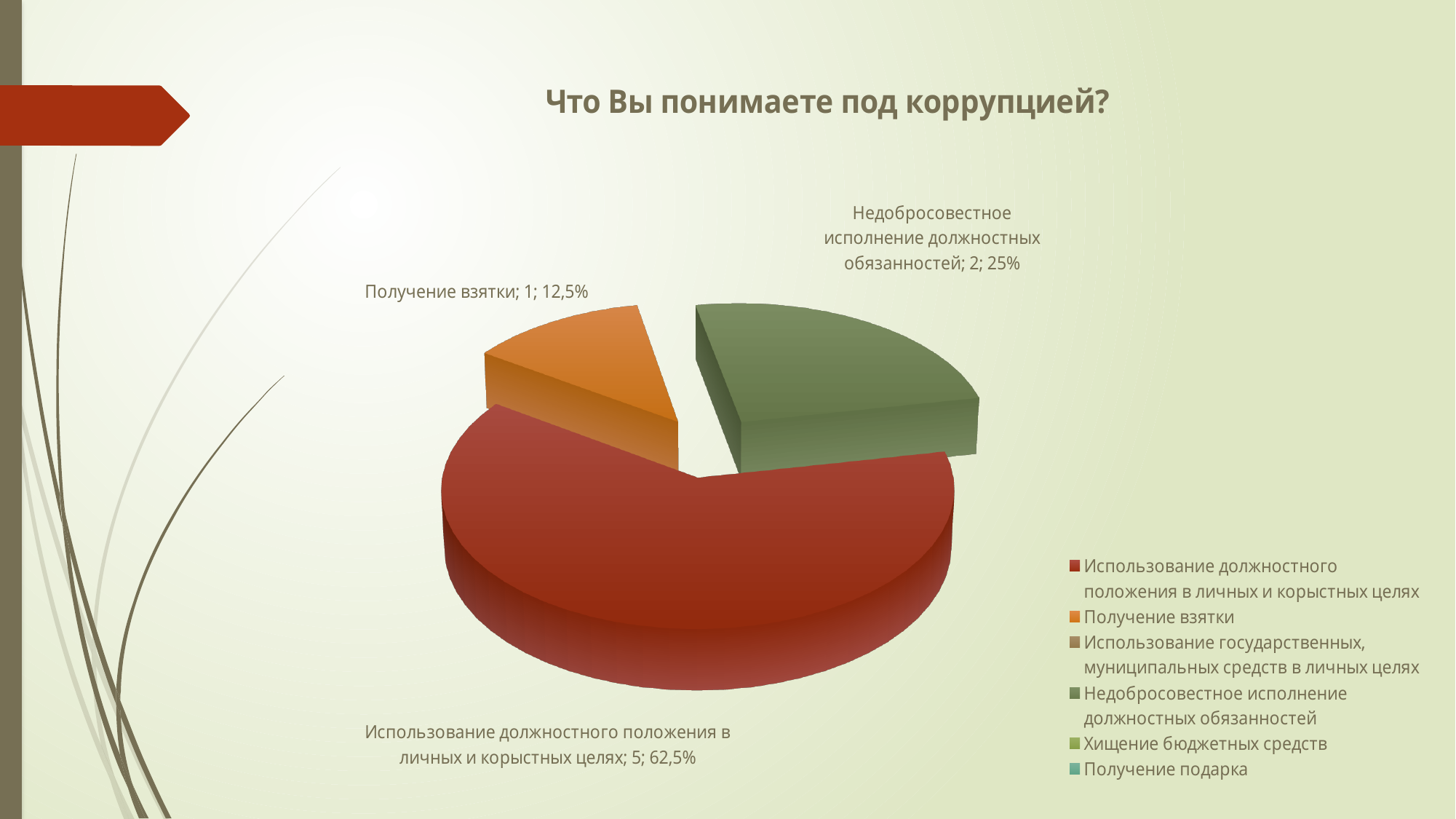
Which category has the largest slice? Использование должностного положения в личных и корыстных целях What is the value for "Получение взятки"? 1 What is the title of the chart? Что Вы понимаете под коррупцией? How many slices are visible in the pie chart? 3 What share of the pie does "Получение взятки" represent? 12,5% What is the value for "Недобросовестное исполнение должностных обязанностей"? 2 What kind of chart is shown on the slide? pie chart How many entries does the legend list? 6 What share of the pie does "Использование должностного положения в личных и корыстных целях" represent? 62,5% What share of the pie does "Недобросовестное исполнение должностных обязанностей" represent? 25% Which of the visible slices is the smallest? Получение взятки What is the difference between the values for "Использование должностного положения в личных и корыстных целях" and "Недобросовестное исполнение должностных обязанностей"? 3